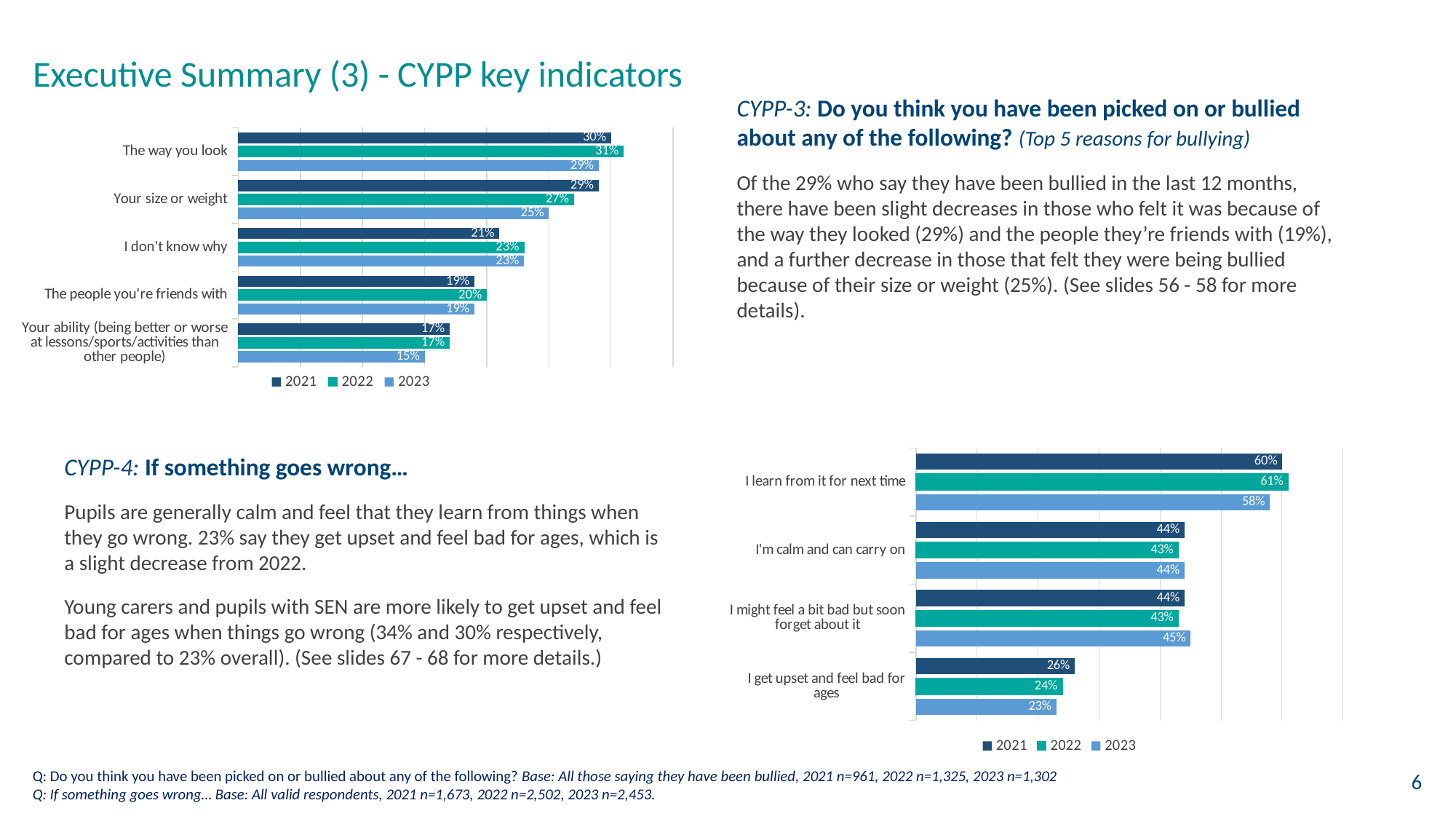
In the top-left chart, how many categories are shown? 5 In the top-left chart, what is the 2022 value for 'The way you look'? 31% In the bottom-right chart, what is the 2022 value for 'I learn from it for next time'? 61% In the bottom-right chart, which is larger: the 2023 value for 'I might feel a bit bad but soon forget about it' or the 2023 value for 'I'm calm and can carry on'? I might feel a bit bad but soon forget about it What type of chart is the bottom-right chart? bar chart In the top-left chart, how many series does the legend list? 3 In the bottom-right chart, which category has the highest 2021 value? I learn from it for next time In the top-left chart, what is the difference between the 2021 and 2023 values for 'Your size or weight'? 4 percentage points In the bottom-right chart, what is the 2023 value for 'I get upset and feel bad for ages'? 23% In the top-left chart, does the value for 'Your size or weight' rise or fall from 2021 to 2023? fall In the top-left chart, what is the 2023 value for 'Your size or weight'? 25% In the top-left chart, which category has the lowest 2023 value? Your ability (being better or worse at lessons/sports/activities than other people)